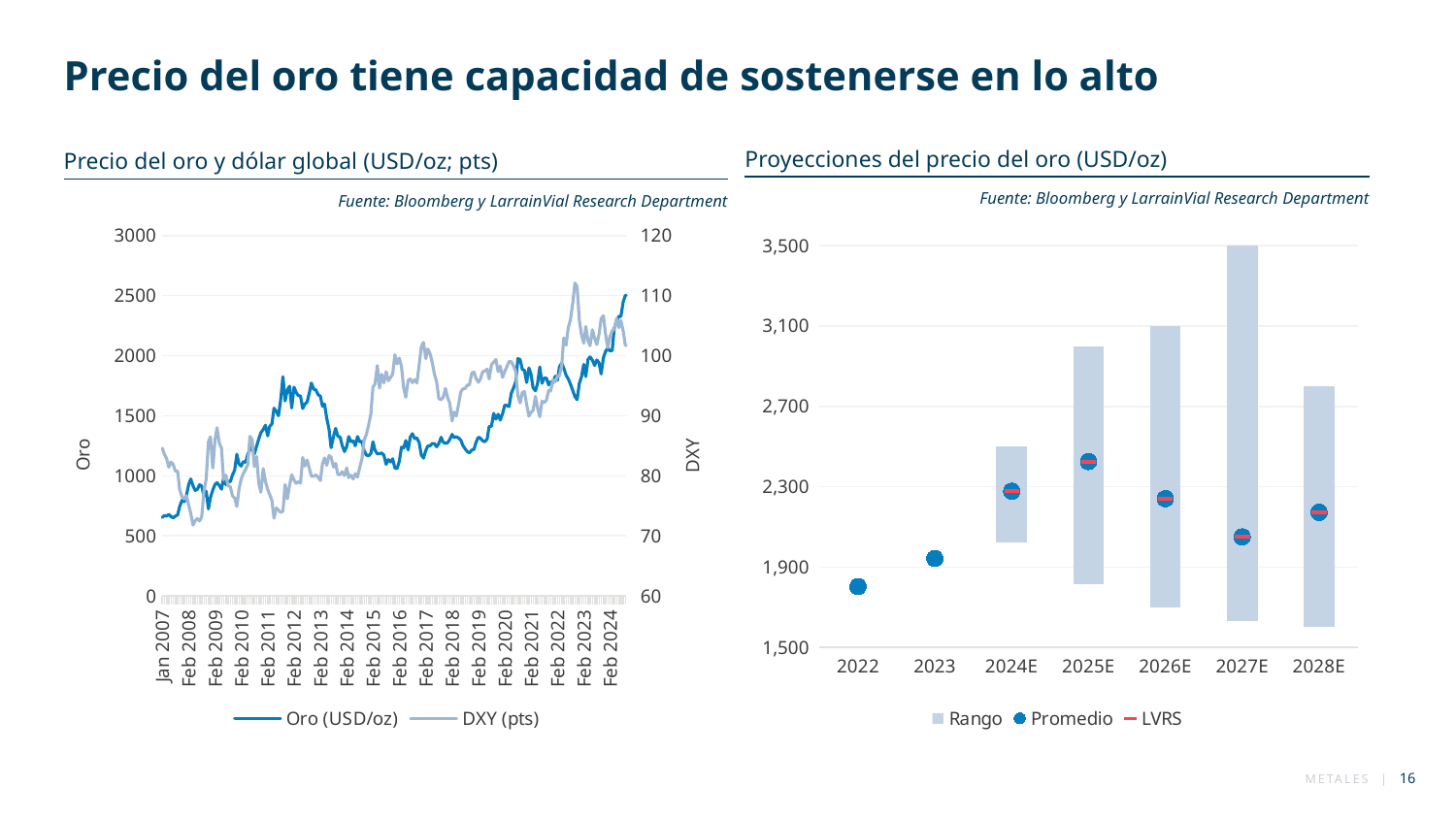
In the right chart 'Proyecciones del precio del oro', which year has the lowest Promedio value? 2022 In the left chart 'Precio del oro y dólar global', does the Oro (USD/oz) series overall rise or fall from Jan 2007 to Feb 2024? rise In the right chart 'Proyecciones del precio del oro', is the top of the Rango bar for 2027E greater or less than 3,100? greater How many series does the legend of the left chart 'Precio del oro y dólar global' list? 2 In the left chart 'Precio del oro y dólar global', which series is plotted against the right-hand DXY axis? DXY (pts) In the right chart 'Proyecciones del precio del oro', is the Promedio value for 2022 greater or less than 1,900? less How many series does the legend of the right chart 'Proyecciones del precio del oro' list? 3 How many categories are shown on the x axis of the right chart 'Proyecciones del precio del oro (USD/oz)'? 7 What kind of chart is the left chart, 'Precio del oro y dólar global (USD/oz; pts)'? line chart In the right chart 'Proyecciones del precio del oro', which year has the Rango bar that reaches the highest value? 2027E In the right chart 'Proyecciones del precio del oro', which year has the highest Promedio value? 2025E